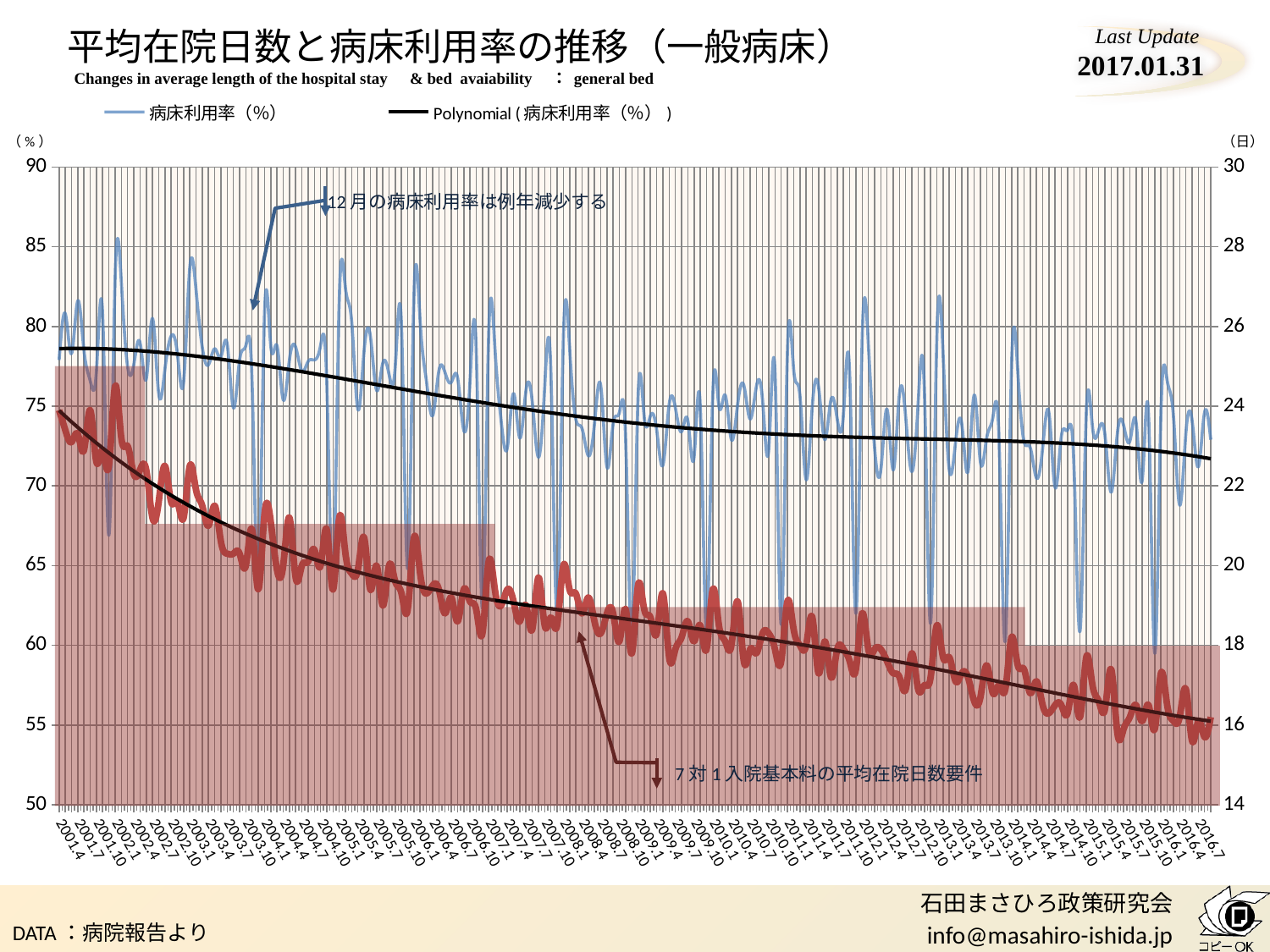
Does the black polynomial trend line for 病床利用率（%） rise or fall from 2001 to 2016? fall Is the black polynomial trend value for 病床利用率（%） at 2016.7 greater or less than 75? less On the right axis (日), is the average length of stay at 2016.7 greater or less than 18? less Is the 病床利用率（%） value at 2001.4 greater or less than 75? greater What is the maximum value shown on the left (%) axis? 90 How many series does the legend at the top of the chart list? 2 What kind of chart is shown on the slide? line chart What is the title of the chart on the slide? 平均在院日数と病床利用率の推移（一般病床） Does the red 平均在院日数 line rise or fall along the x axis from 2001.4 to 2016.7? fall